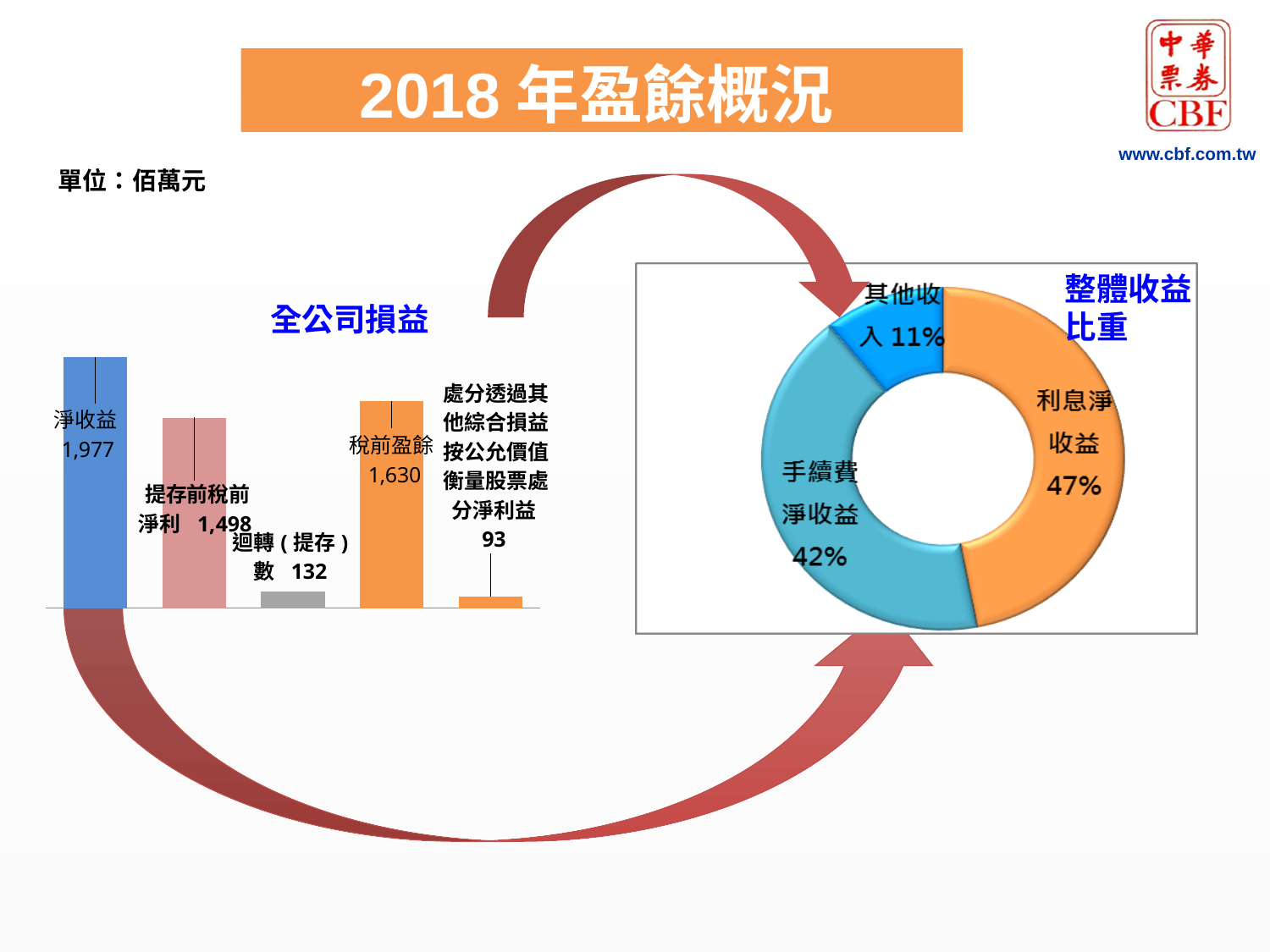
In the 全公司損益 bar chart, what is the difference between 淨收益 and 提存前稅前淨利? 479 What type of chart is the 整體收益比重 chart? Doughnut chart In the 全公司損益 bar chart, which category has the highest value? 淨收益 How many bars are shown in the 全公司損益 bar chart? 5 In the 全公司損益 bar chart, what is the value for 淨收益? 1,977 In the 整體收益比重 chart, which segment is the smallest? 其他收入 What type of chart is the 全公司損益 chart? Bar chart In the 全公司損益 bar chart, what is the value for 迴轉（提存）數? 132 In the 全公司損益 bar chart, what is the value for 稅前盈餘? 1,630 In the 全公司損益 bar chart, which is larger, 稅前盈餘 or 提存前稅前淨利? 稅前盈餘 In the 全公司損益 bar chart, which category has the lowest value? 處分透過其他綜合損益按公允價值衡量股票處分淨利益 In the 整體收益比重 chart, what share does 利息淨收益 have? 47%